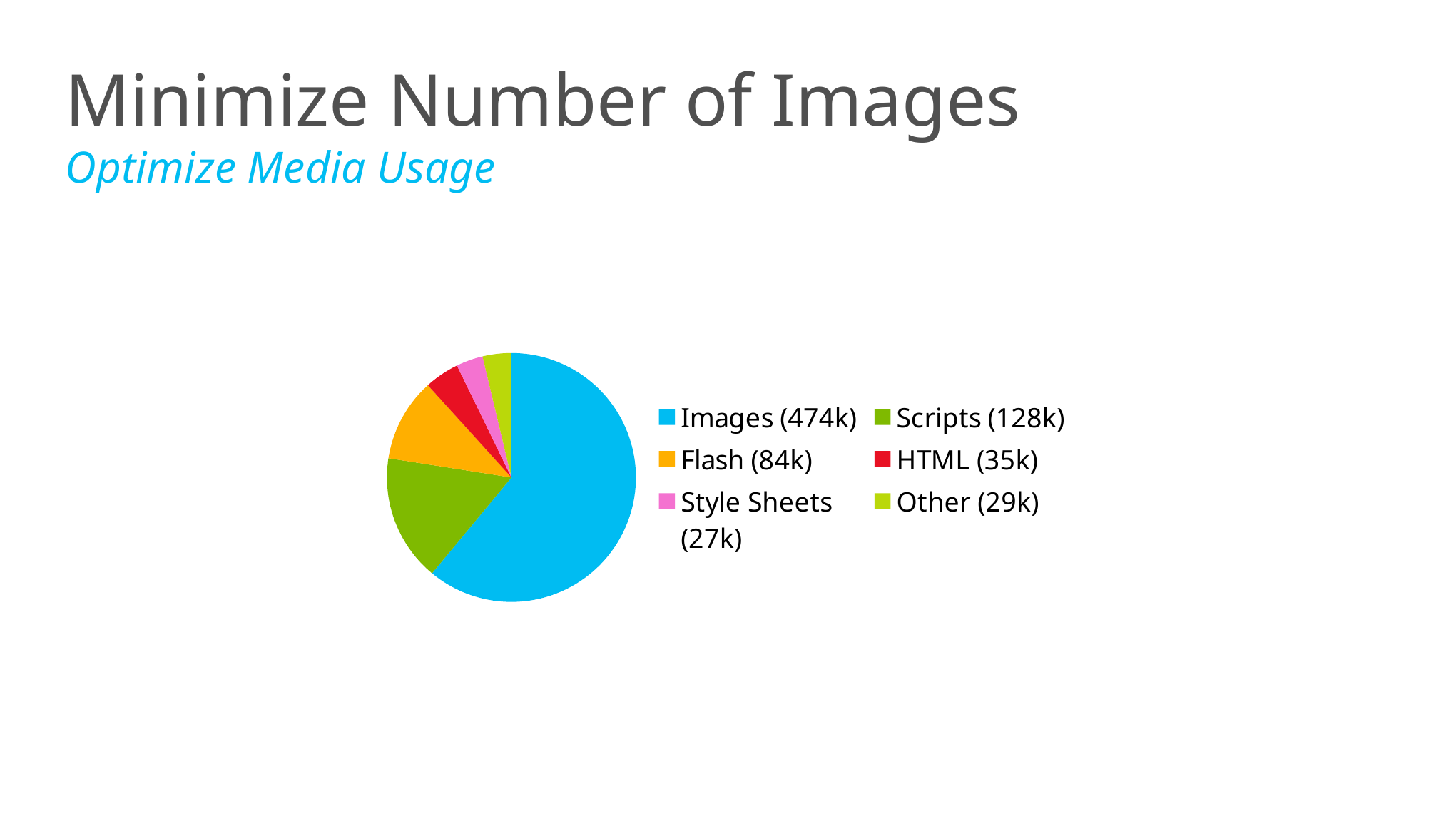
What is the value for Style Sheets in the pie chart? 27k Which category has the largest slice of the pie chart? Images How many categories does the pie chart show? 6 Which is larger, the value for Flash or the value for HTML? Flash What is the value for Scripts in the pie chart? 128k What kind of chart is shown on the slide? pie chart What is the difference between the values for Images and Scripts? 346k Which category has the smallest value in the pie chart? Style Sheets What is the value for Images in the pie chart? 474k What colour is the Images slice in the pie chart? blue What is the value for Flash in the pie chart? 84k What is the total of all the values shown in the pie chart legend? 777k